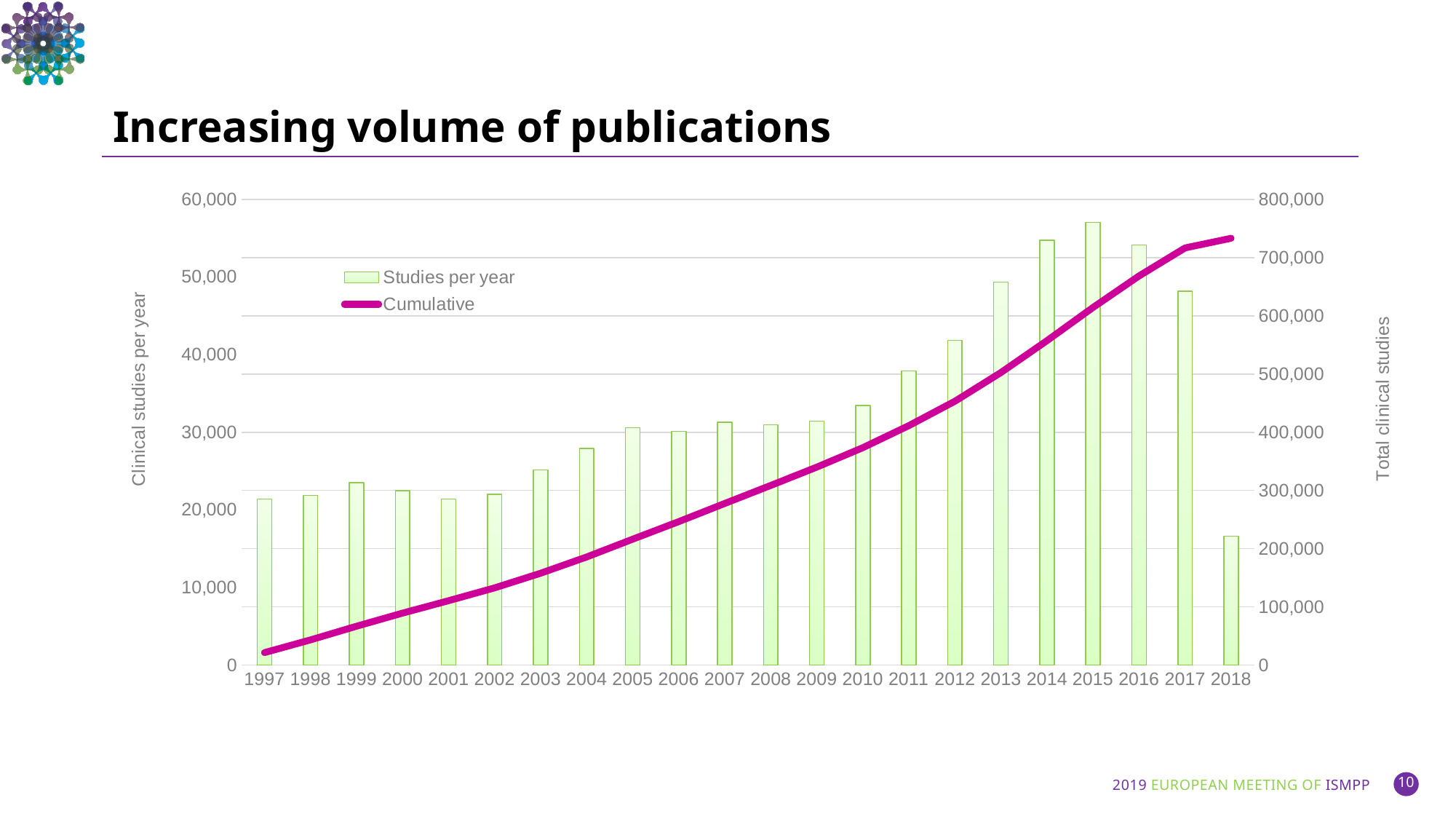
Is the Studies per year value for 2015 greater or less than 50,000? greater Which year has a larger Studies per year value, 2013 or 2012? 2013 Which year has the lowest bar for Studies per year? 2018 Is the Studies per year value for 2018 greater or less than 20,000? less Is the Cumulative value for 2018 greater or less than 700,000? greater How many years are shown on the x axis of the chart? 22 What is the title of the right-hand vertical axis? Total clinical studies Which year has the highest bar for Studies per year? 2015 How many series does the chart's legend list? 2 What kind of chart is shown on the slide? A combined bar and line chart Does the Cumulative line rise or fall from 1997 to 2018? It rises